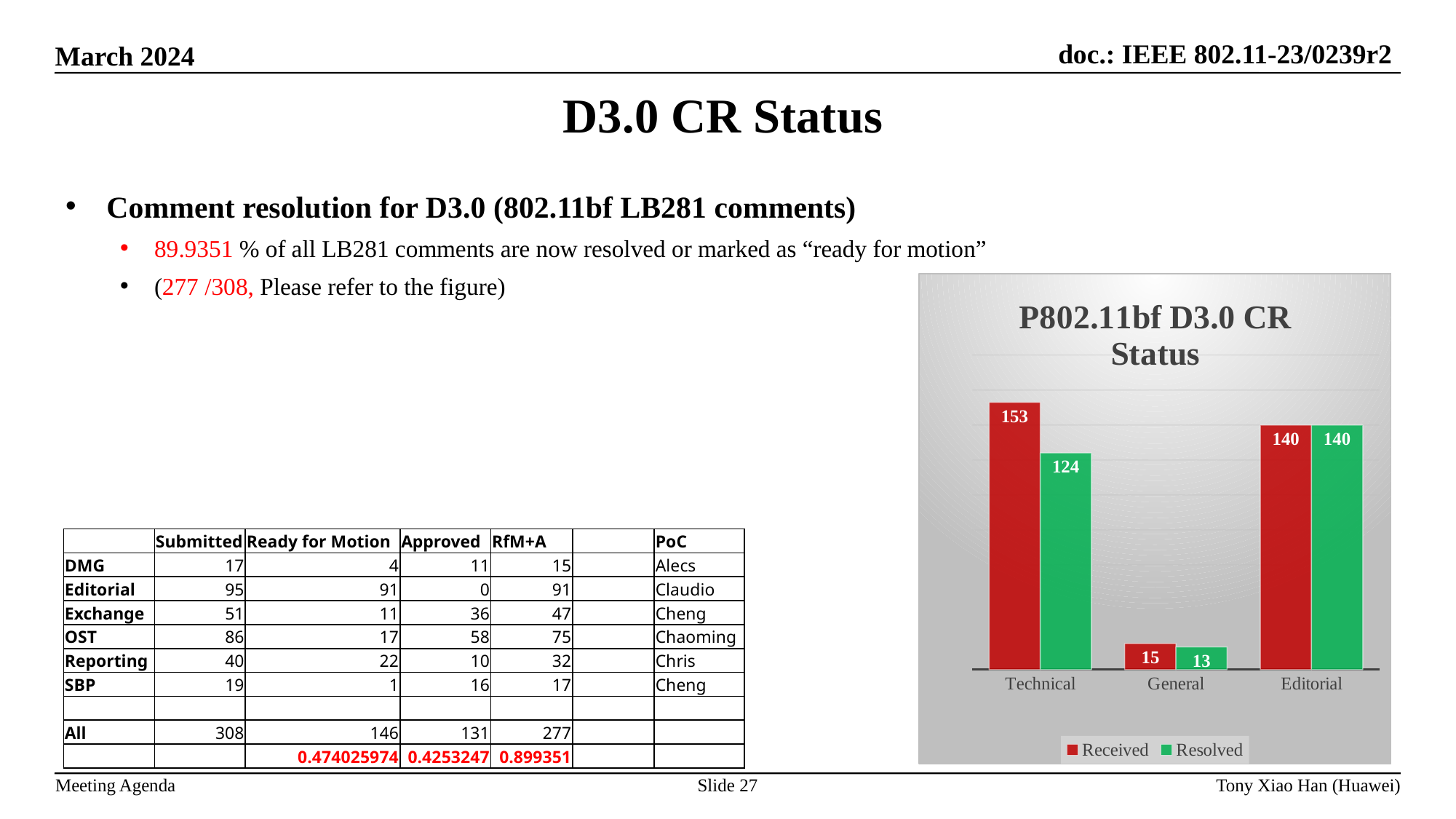
What colour are the Resolved bars? green How many categories are shown on the x axis? 3 What is the Resolved value for Editorial? 140 What is the title of the chart? P802.11bf D3.0 CR Status What is the Resolved value for General? 13 Which category has the lowest Resolved value? General What is the Received value for Technical? 153 How many series does the legend list? 2 What kind of chart is shown? bar chart Which is larger for General, Received or Resolved? Received Which category has the highest Received value? Technical What is the difference between Received and Resolved for Technical? 29